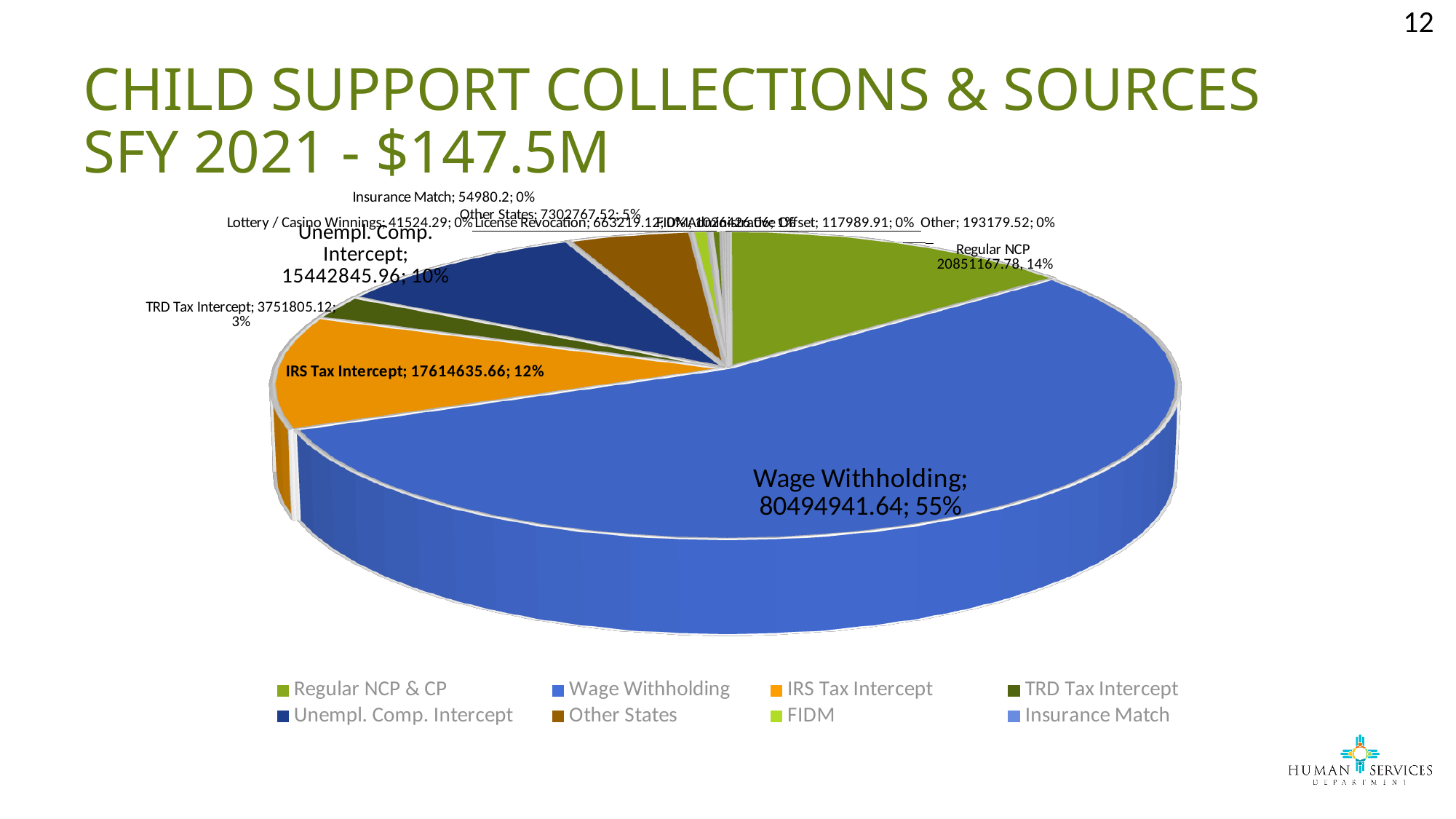
What kind of chart is shown on the slide? pie chart How many entries does the legend list? 8 What is the collection amount for Wage Withholding? 80494941.64 Which is larger, the share for Regular NCP or the share for IRS Tax Intercept? Regular NCP What is the collection amount for IRS Tax Intercept? 17614635.66 What is the collection amount for TRD Tax Intercept? 3751805.12 What total collection amount is stated in the slide title for SFY 2021? $147.5M Which source accounts for the largest share of child support collections? Wage Withholding What is the difference in percentage points between the Wage Withholding share and the Regular NCP share? 41 What share of collections comes from Wage Withholding? 55% What share of collections comes from Unempl. Comp. Intercept? 10% What share of collections comes from IRS Tax Intercept? 12%